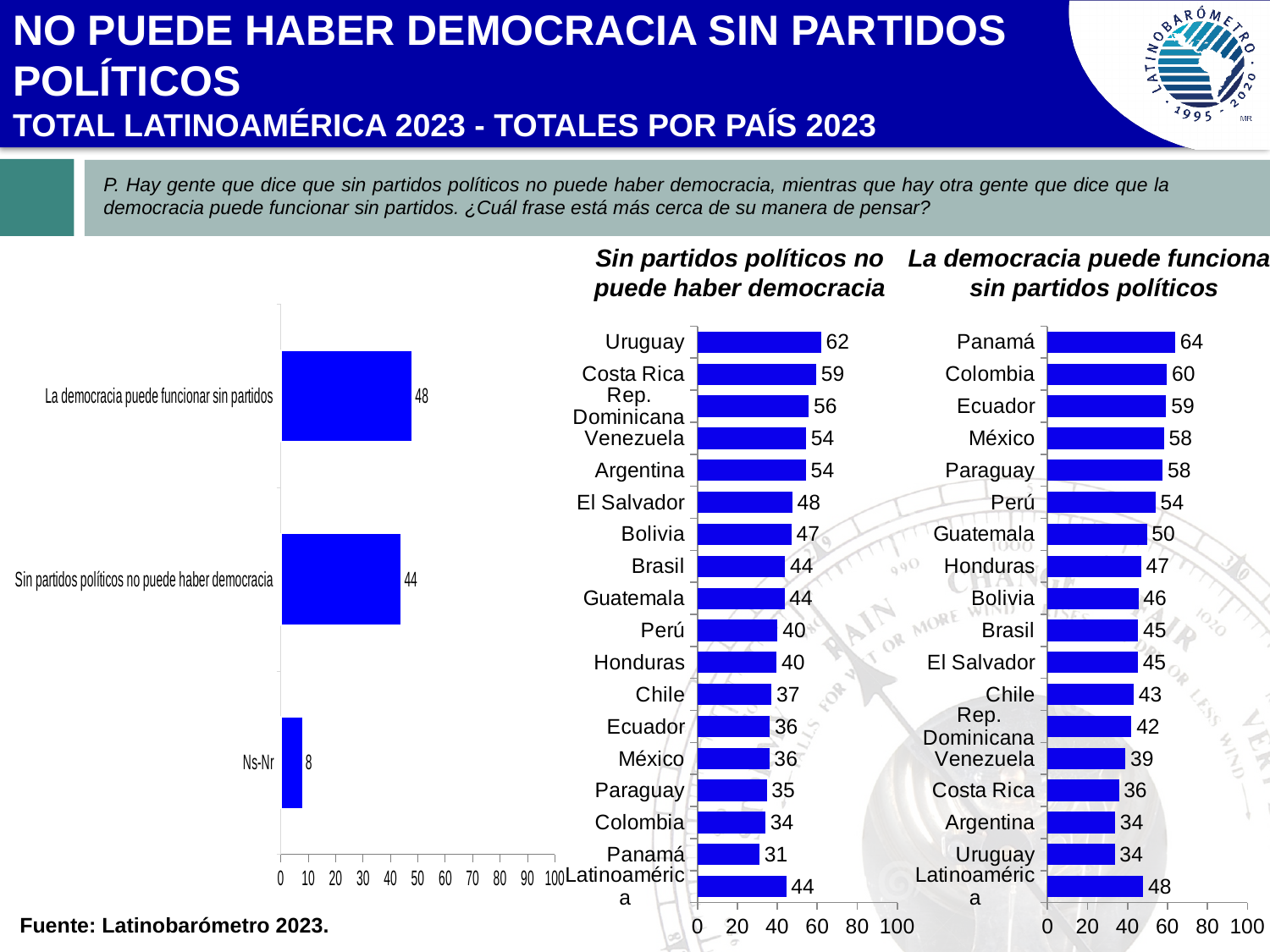
In the chart titled 'La democracia puede funcionar sin partidos políticos', what is the difference between Panamá and Uruguay? 30 What kind of chart is the chart titled 'Sin partidos políticos no puede haber democracia'? Bar chart In the chart titled 'Sin partidos políticos no puede haber democracia', which country has the highest value? Uruguay In the left chart, what is the value for 'Ns-Nr'? 8 In the chart titled 'Sin partidos políticos no puede haber democracia', what is the value for Latinoamérica? 44 In the left chart, what is the value for 'La democracia puede funcionar sin partidos'? 48 In the left chart, what is the difference between 'La democracia puede funcionar sin partidos' and 'Sin partidos políticos no puede haber democracia'? 4 In the chart titled 'Sin partidos políticos no puede haber democracia', which country has the lowest value? Panamá In the chart titled 'La democracia puede funcionar sin partidos políticos', what is the value for Guatemala? 50 In the chart titled 'Sin partidos políticos no puede haber democracia', what is the value for Bolivia? 47 In the chart titled 'La democracia puede funcionar sin partidos políticos', which is larger, the value for Ecuador or the value for Chile? Ecuador In the chart titled 'La democracia puede funcionar sin partidos políticos', which country has the highest value? Panamá